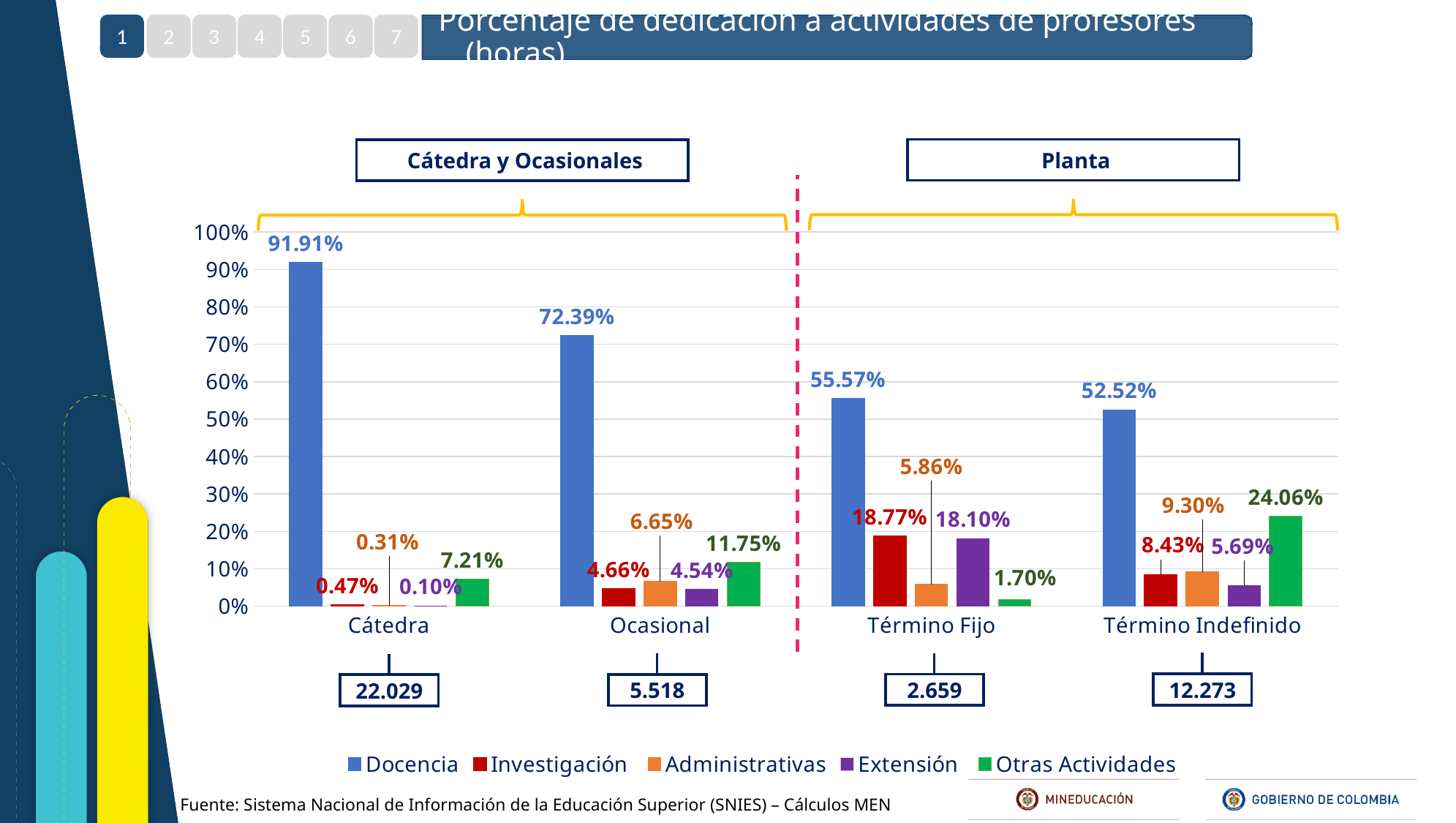
What kind of chart is shown on the slide? Bar chart What is the difference between the Docencia values for Cátedra and Ocasional? 19.52% What is the Otras Actividades value for Término Indefinido? 24.06% What is the Docencia value for Cátedra? 91.91% Which category has the lowest Otras Actividades value? Término Fijo How many series does the legend list? 5 Which is larger, the Extensión value for Término Fijo or for Término Indefinido? Término Fijo What is the Administrativas value for Ocasional? 6.65% How many categories are shown on the x axis? 4 Is the Docencia value for Término Indefinido greater or less than 50%? greater What is the Investigación value for Término Fijo? 18.77% Which category has the highest Docencia value? Cátedra